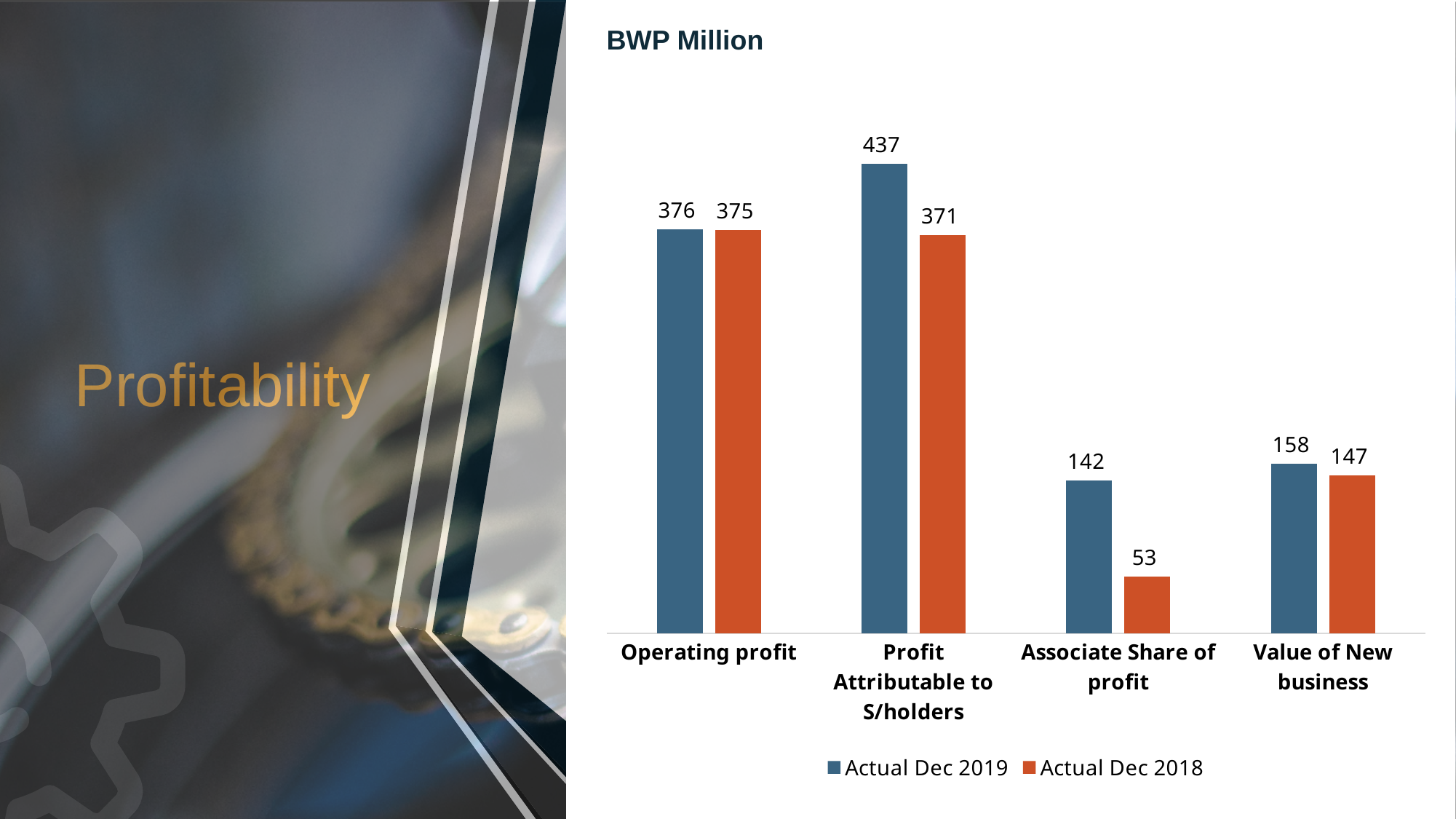
What is the Actual Dec 2019 value for Operating profit? 376 How many series does the legend list? 2 What is the difference between the Actual Dec 2019 and Actual Dec 2018 values for Profit Attributable to S/holders? 66 What is the Actual Dec 2019 value for Value of New business? 158 What is the Actual Dec 2018 value for Associate Share of profit? 53 How many categories are shown on the x axis? 4 What is the Actual Dec 2018 value for Profit Attributable to S/holders? 371 What kind of chart is shown on the slide? Bar chart Which category has the highest Actual Dec 2019 value? Profit Attributable to S/holders Which category has the lowest Actual Dec 2018 value? Associate Share of profit Which is larger for Associate Share of profit: Actual Dec 2019 or Actual Dec 2018? Actual Dec 2019 What is the difference between the Actual Dec 2019 and Actual Dec 2018 values for Associate Share of profit? 89